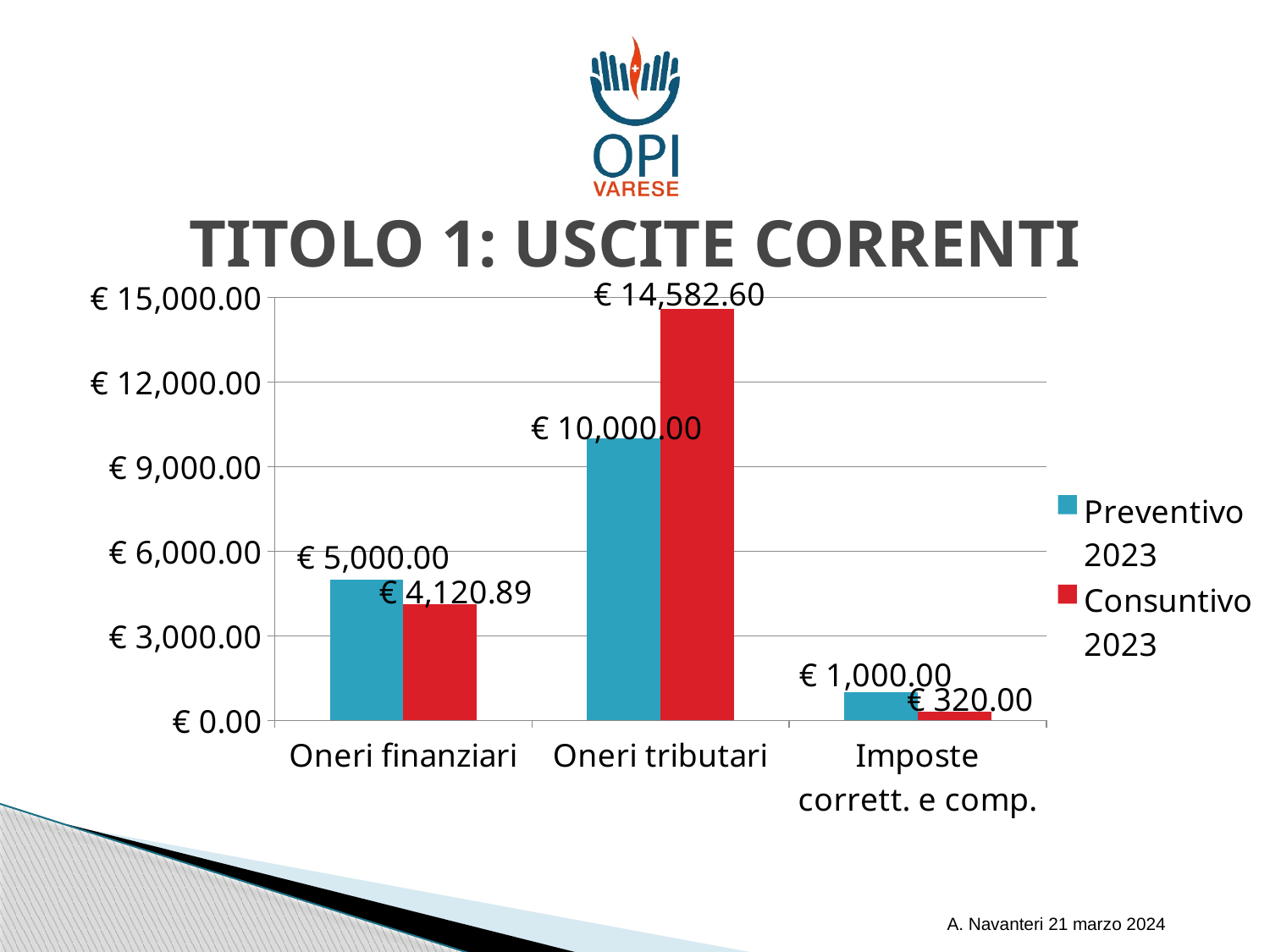
For Oneri finanziari, which is larger: Preventivo 2023 or Consuntivo 2023? Preventivo 2023 What type of chart is shown on the slide? Bar chart How many series does the legend list? 2 What is the Consuntivo 2023 value for Oneri tributari? € 14,582.60 What is the difference between the Preventivo 2023 and Consuntivo 2023 values for Imposte corrett. e comp.? € 680.00 What is the Consuntivo 2023 value for Oneri finanziari? € 4,120.89 What is the difference between the Consuntivo 2023 and Preventivo 2023 values for Oneri tributari? € 4,582.60 What is the Consuntivo 2023 value for Imposte corrett. e comp.? € 320.00 What is the Preventivo 2023 value for Oneri finanziari? € 5,000.00 Which category has the highest Consuntivo 2023 value? Oneri tributari How many categories are shown on the x axis? 3 Which category has the lowest Preventivo 2023 value? Imposte corrett. e comp.